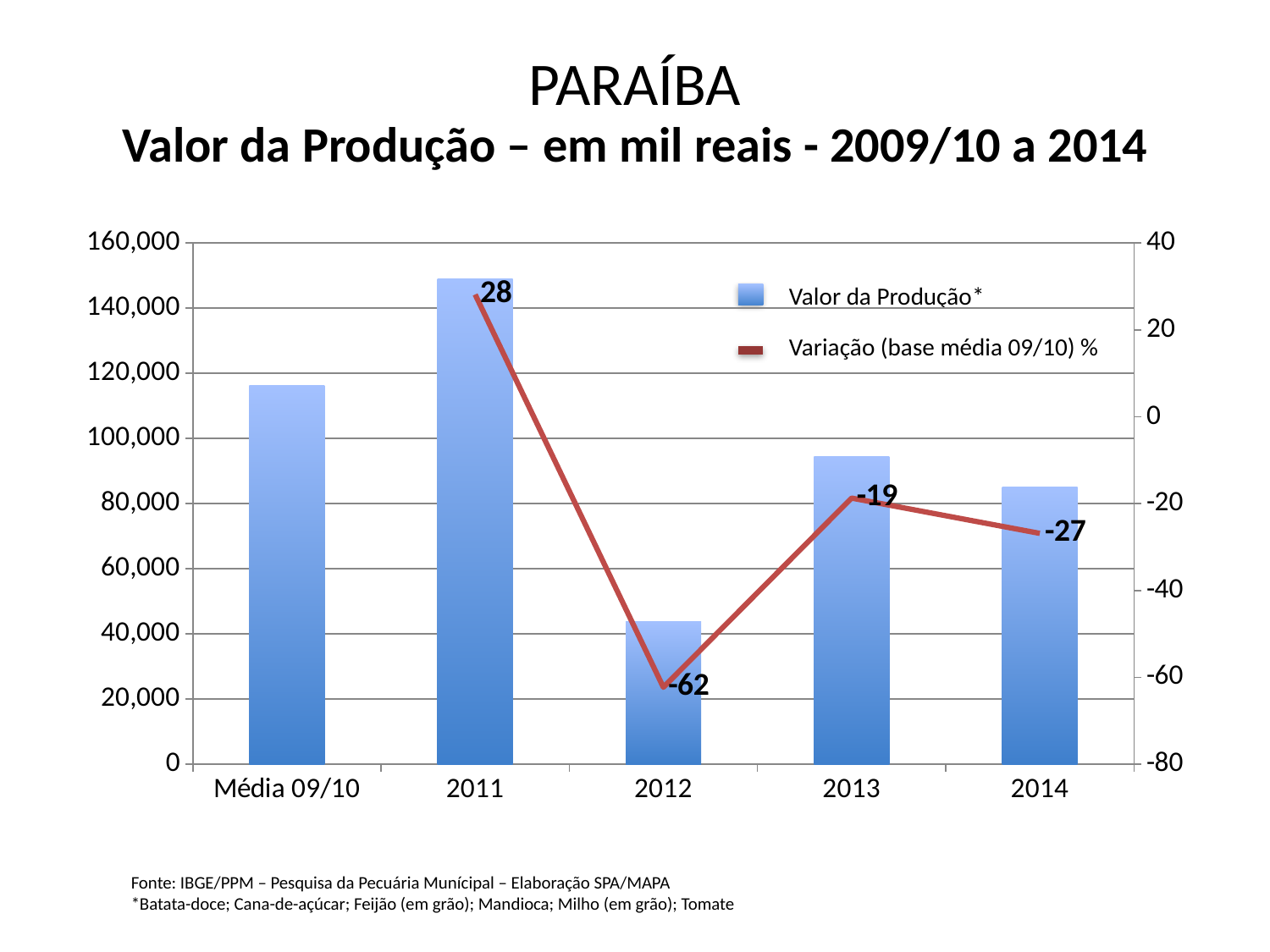
What is the value of Variação (base média 09/10) % for 2012? -62 What is the value of Variação (base média 09/10) % for 2014? -27 Is the Valor da Produção for Média 09/10 greater or less than 100,000? greater What is the value of Variação (base média 09/10) % for 2011? 28 Is the Valor da Produção for 2012 greater or less than 60,000? less Does the Variação line rise or fall from 2013 to 2014? fall What is the difference between the Variação values for 2011 and 2012? 90 How many series does the legend list? 2 Which year has the lowest Valor da Produção bar? 2012 How many categories are shown on the x axis? 5 Which year has the highest Valor da Produção bar? 2011 Which is larger, the Valor da Produção for 2013 or for 2014? 2013